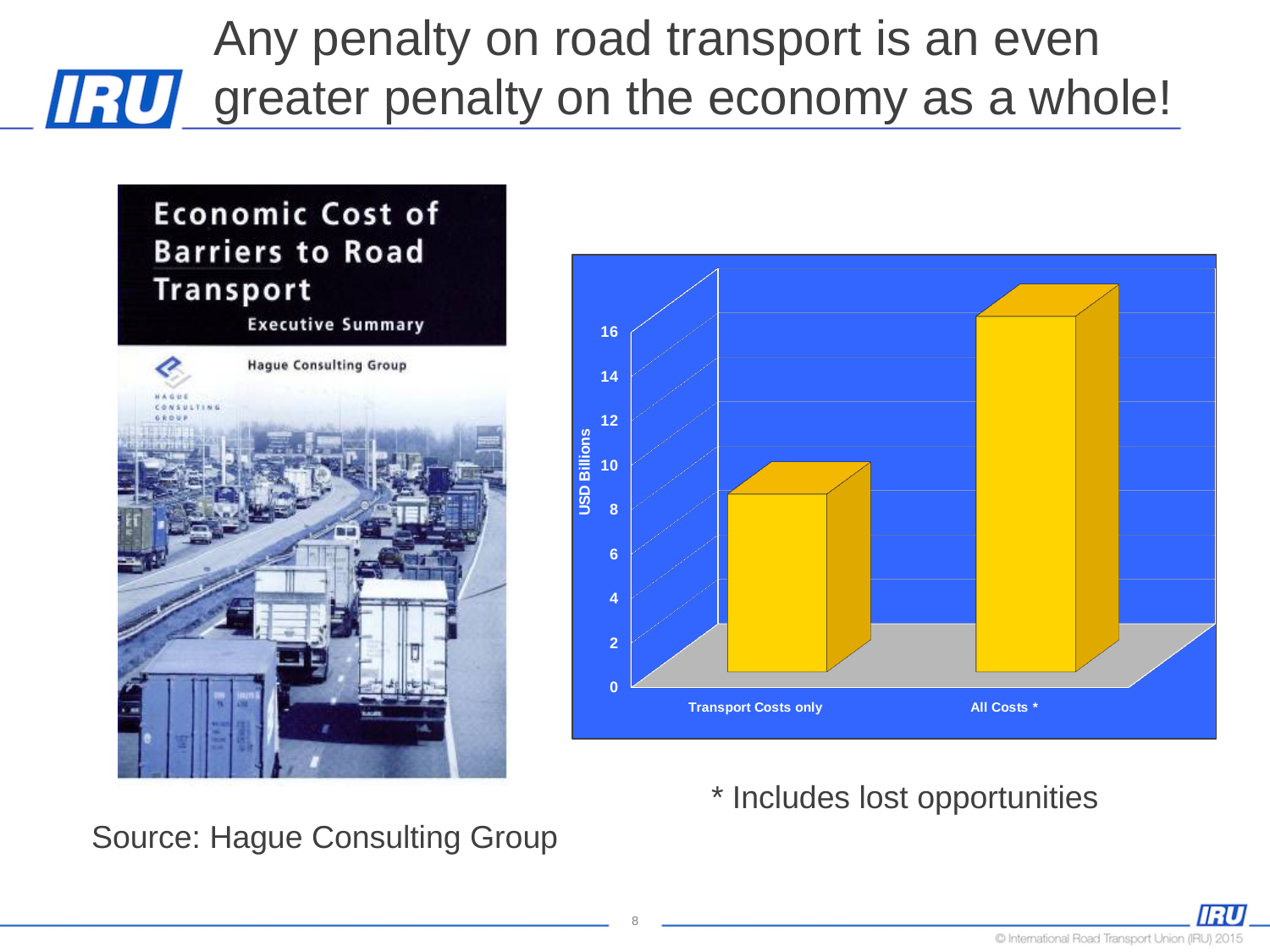
How many categories are plotted in the bar chart? 2 Is the value for All Costs * greater or less than 12? greater What is the highest tick value shown on the vertical axis of the chart? 16 Which is larger, the value for Transport Costs only or the value for All Costs *? All Costs * Which category has the highest bar in the chart? All Costs * What is the label on the vertical axis of the chart? USD Billions Which category has the lowest bar in the chart? Transport Costs only What kind of chart is shown on the slide? bar chart Is the value for Transport Costs only greater or less than 10? less Is the value for Transport Costs only greater or less than 6? greater